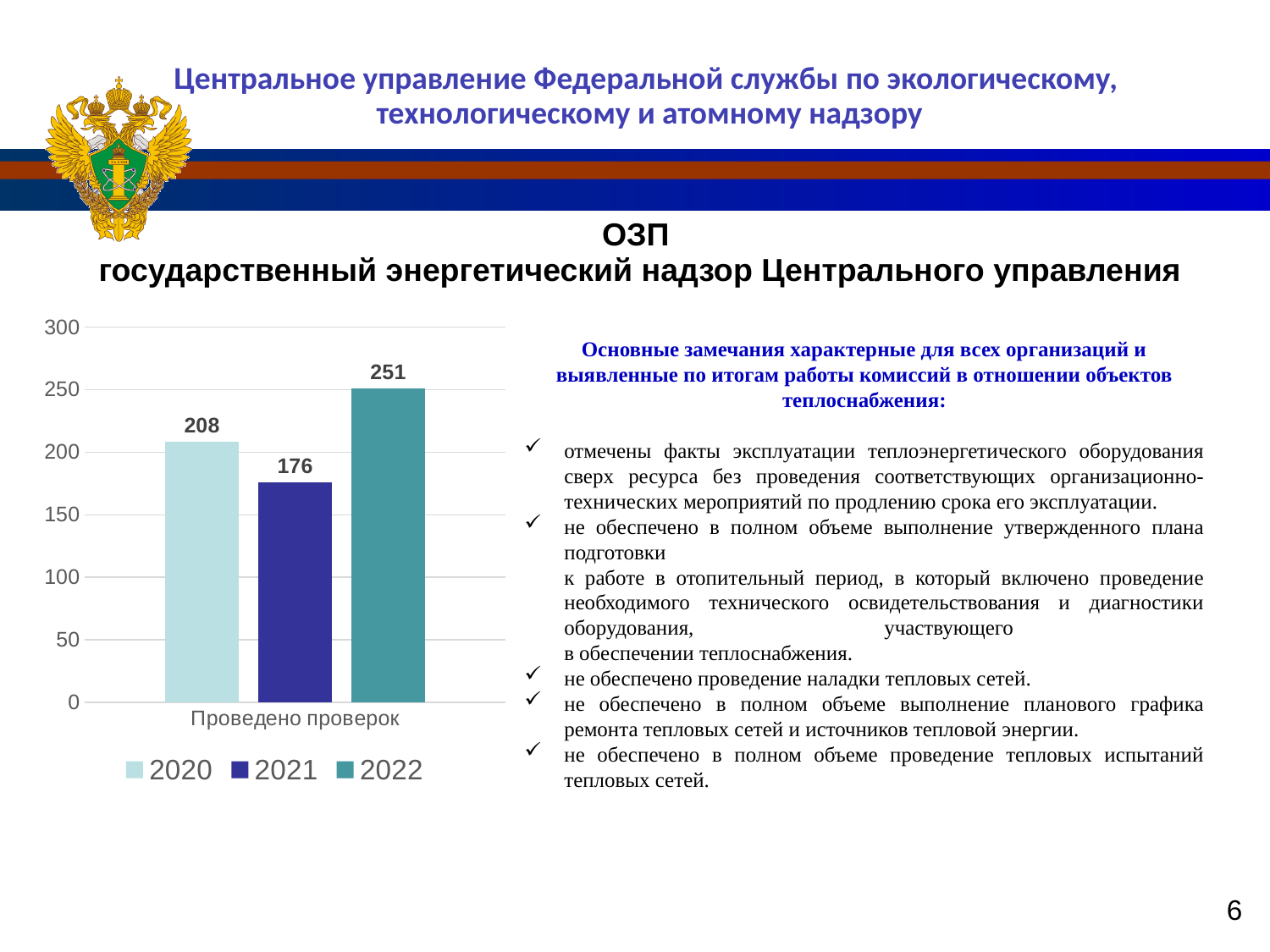
What kind of chart is shown on the slide? bar chart What is the value for 2022 in the 'Проведено проверок' chart? 251 Which year has the highest number of 'Проведено проверок'? 2022 Is the value for 2021 greater or less than 200? less Which year has the lowest number of 'Проведено проверок'? 2021 What is the category label shown on the x axis of the chart? Проведено проверок How many series does the legend list? 3 What is the difference between the 2020 and 2021 values for 'Проведено проверок'? 32 What is the value for 2020 in the 'Проведено проверок' chart? 208 What is the difference between the 2022 and 2021 values for 'Проведено проверок'? 75 Which is larger, the value for 2020 or the value for 2022? 2022 What is the value for 2021 in the 'Проведено проверок' chart? 176